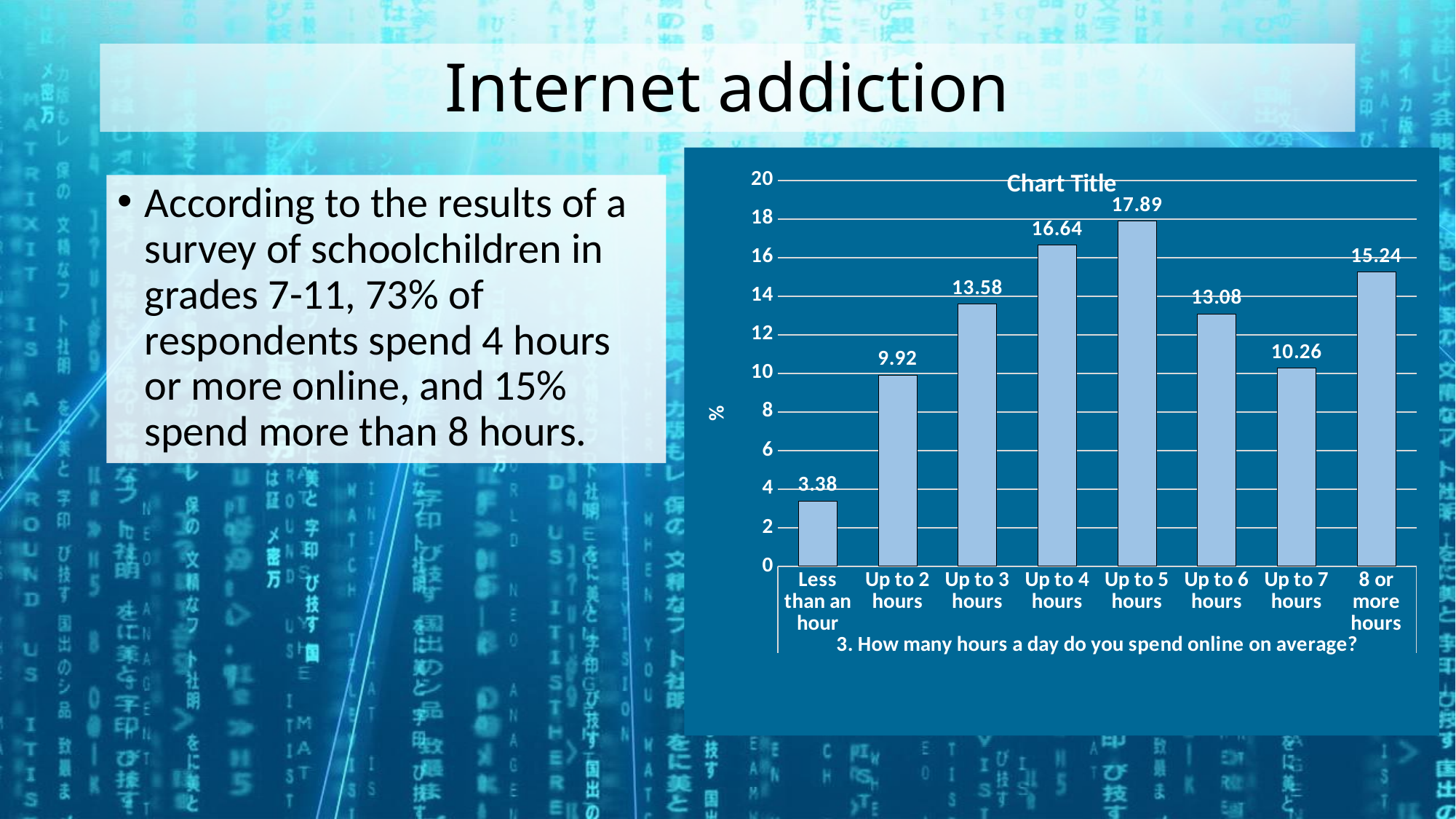
What kind of chart is shown? bar chart Which category has the highest value? Up to 5 hours Which category has the lowest value? Less than an hour What is the value for 'Less than an hour'? 3.38 What is the value for 'Up to 5 hours'? 17.89 What is the value for '8 or more hours'? 15.24 Is the value for 'Up to 3 hours' greater or less than 12? greater How many categories are shown on the x axis? 8 What is the label on the y axis? % What is the difference between the values for 'Up to 5 hours' and 'Up to 4 hours'? 1.25 Which is larger, the value for 'Up to 6 hours' or the value for 'Up to 7 hours'? Up to 6 hours What is the x-axis title of the chart? 3. How many hours a day do you spend online on average?